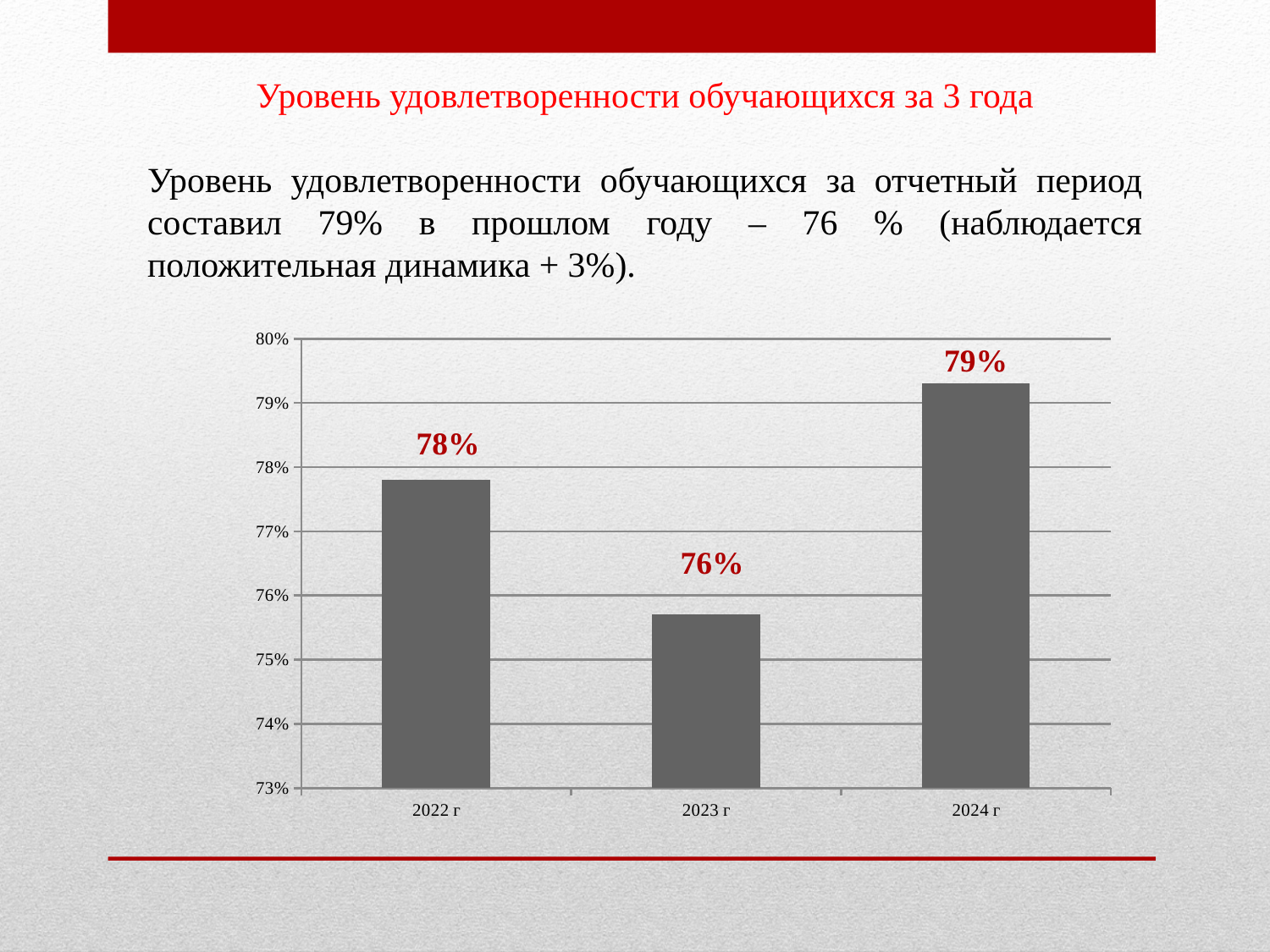
What kind of chart is shown on the slide? bar chart Does the value rise or fall from 2023 г to 2024 г? rise Is the value for 2023 г greater or less than 77%? less What is the value for 2022 г? 78% What is the difference between the values for 2024 г and 2023 г? 3% Which is larger, the value for 2022 г or the value for 2024 г? 2024 г Which year has the lowest value? 2023 г What is the value for 2023 г? 76% What is the value for 2024 г? 79% How many years are shown on the x axis? 3 What is the difference between the values for 2022 г and 2023 г? 2% Which year has the highest value? 2024 г